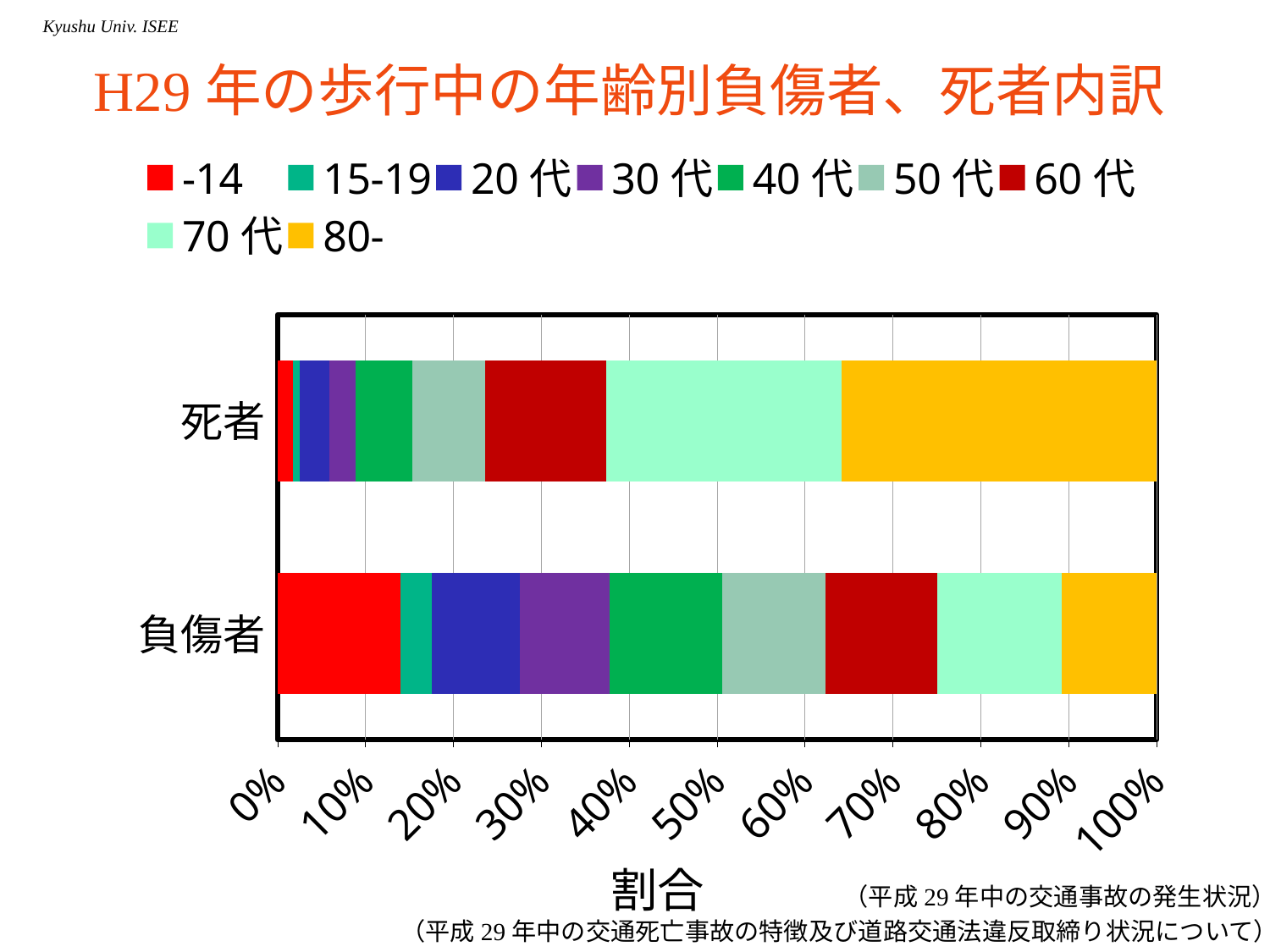
How many series does the legend list? 9 Is the share of the -14 group in the 負傷者 bar greater or less than 10%? greater How many categories (bars) does the chart show? 2 What is the label of the horizontal axis? 割合 Which bar has the larger share for the -14 group, 死者 or 負傷者? 負傷者 Is the share of the 80- group in the 死者 bar greater or less than 30%? greater Which age group has the smallest share of the 負傷者 bar? 15-19 Which age group has the largest share of the 死者 bar? 80- What kind of chart is shown on the slide? Stacked bar chart Which bar has the larger share for the 80- group, 死者 or 負傷者? 死者 What is the title of the chart on the slide? H29年の歩行中の年齢別負傷者、死者内訳 Which age group has the smallest share of the 死者 bar? 15-19